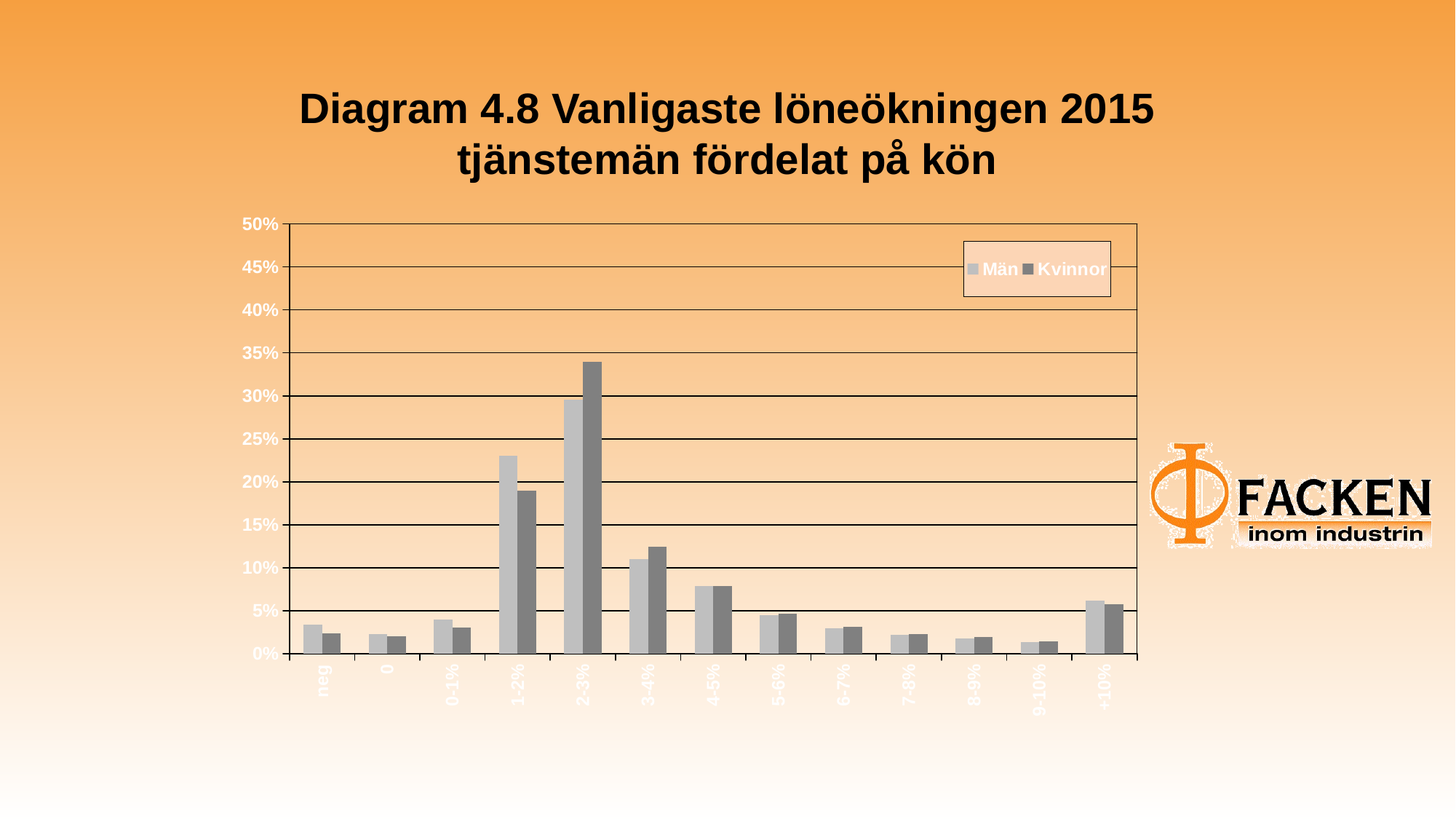
For which category is the Män value highest? 2-3% For which category is the Kvinnor value highest? 2-3% Is the Kvinnor value for 2-3% greater or less than 30%? greater In the 1-2% category, which series has the larger value, Män or Kvinnor? Män How many series does the legend list? 2 What kind of chart is shown on the slide? bar chart Is the Kvinnor value for 1-2% greater or less than 20%? less In the 2-3% category, which series has the larger value, Män or Kvinnor? Kvinnor Is the Män value for 1-2% greater or less than 20%? greater How many categories are shown along the x axis? 13 Which series are listed in the legend? Män and Kvinnor